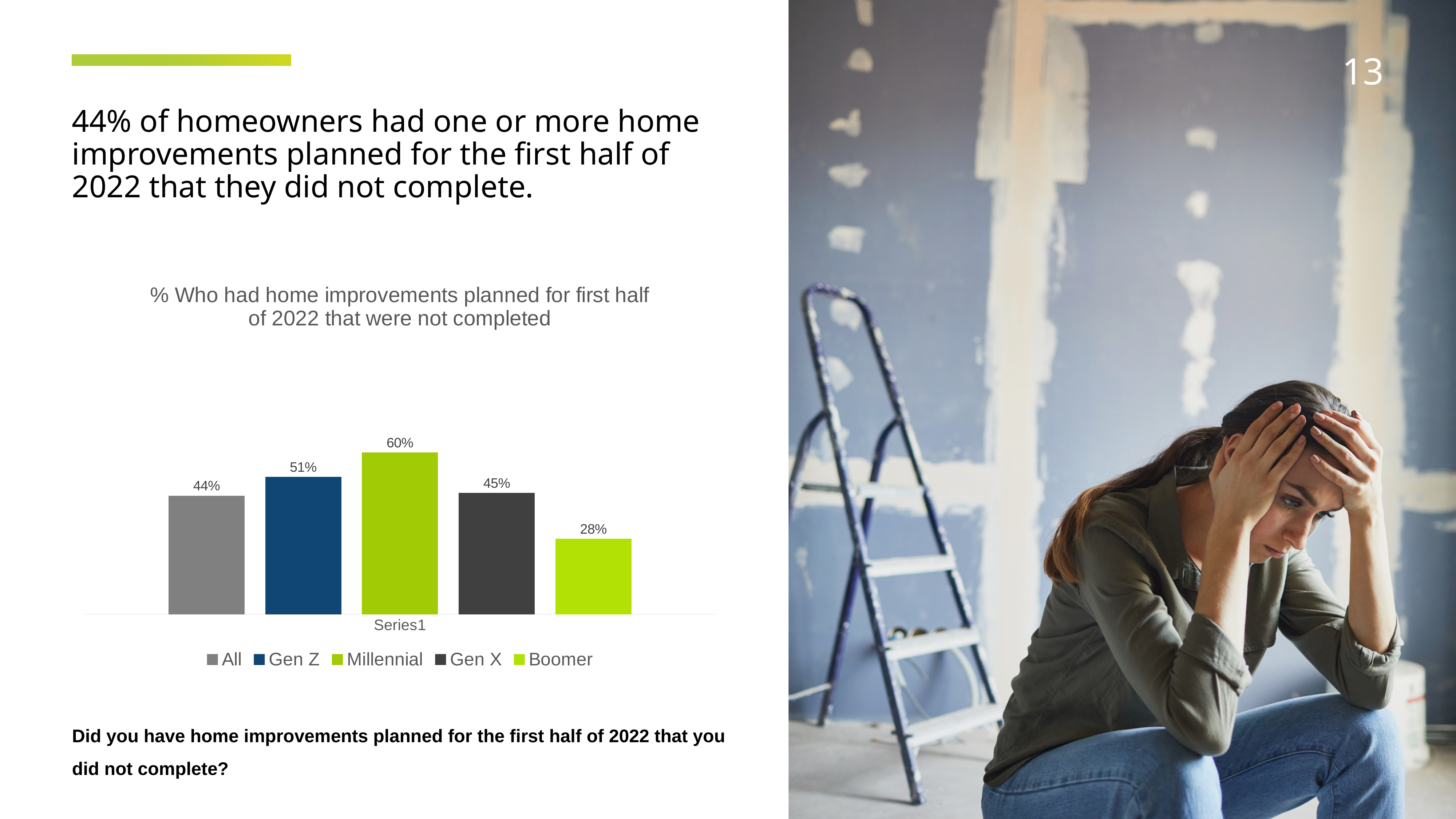
What is the value for Gen Z? 51% What is the value for All? 44% What is the title of the chart? % Who had home improvements planned for first half of 2022 that were not completed Which group has the highest value? Millennial Which is larger, the value for Gen Z or the value for Gen X? Gen Z Which group has the lowest value? Boomer What is the difference between the Millennial and Boomer values? 32% What is the value for Boomer? 28% How many series does the legend list? 5 What is the value for Millennial? 60% What is the difference between the Gen Z and Gen X values? 6% What kind of chart is shown? Bar chart